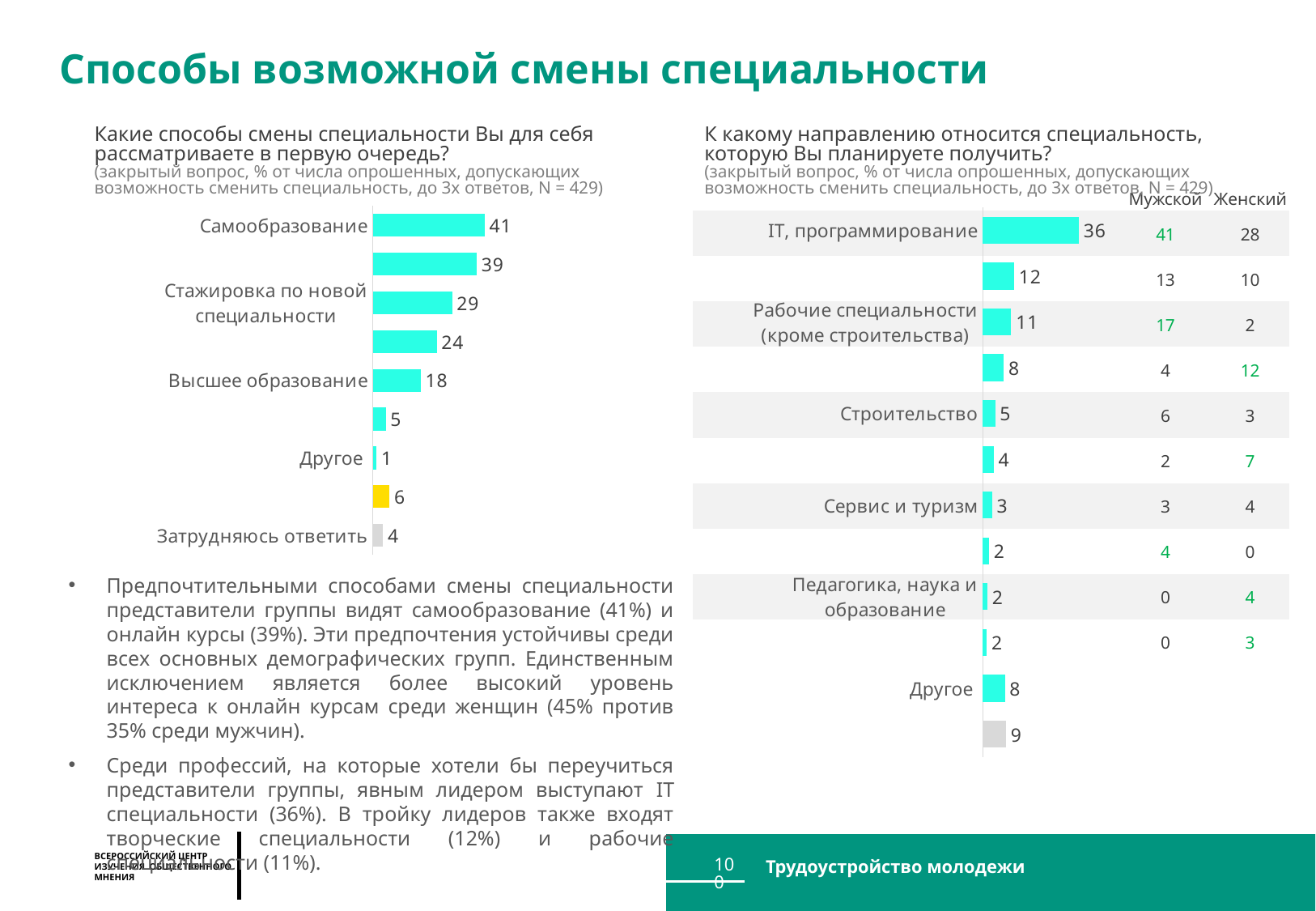
In the right chart, what is the value for Рабочие специальности (кроме строительства)? 11 In the right chart, which is larger: Сервис и туризм or Другое? Другое In the left chart, what is the value for Самообразование? 41 In the left chart, which labelled category has the highest value? Самообразование In the left chart, what is the value for Затрудняюсь ответить? 4 In the left chart, what is the value for Высшее образование? 18 What type of chart is the left chart? Bar chart In the left chart, what is the value for Стажировка по новой специальности? 29 In the right chart, what is the value for IT, программирование? 36 In the right chart, what is the Мужской value for IT, программирование? 41 In the right chart, what is the value for Строительство? 5 In the left chart, what is the difference between Самообразование and Высшее образование? 23